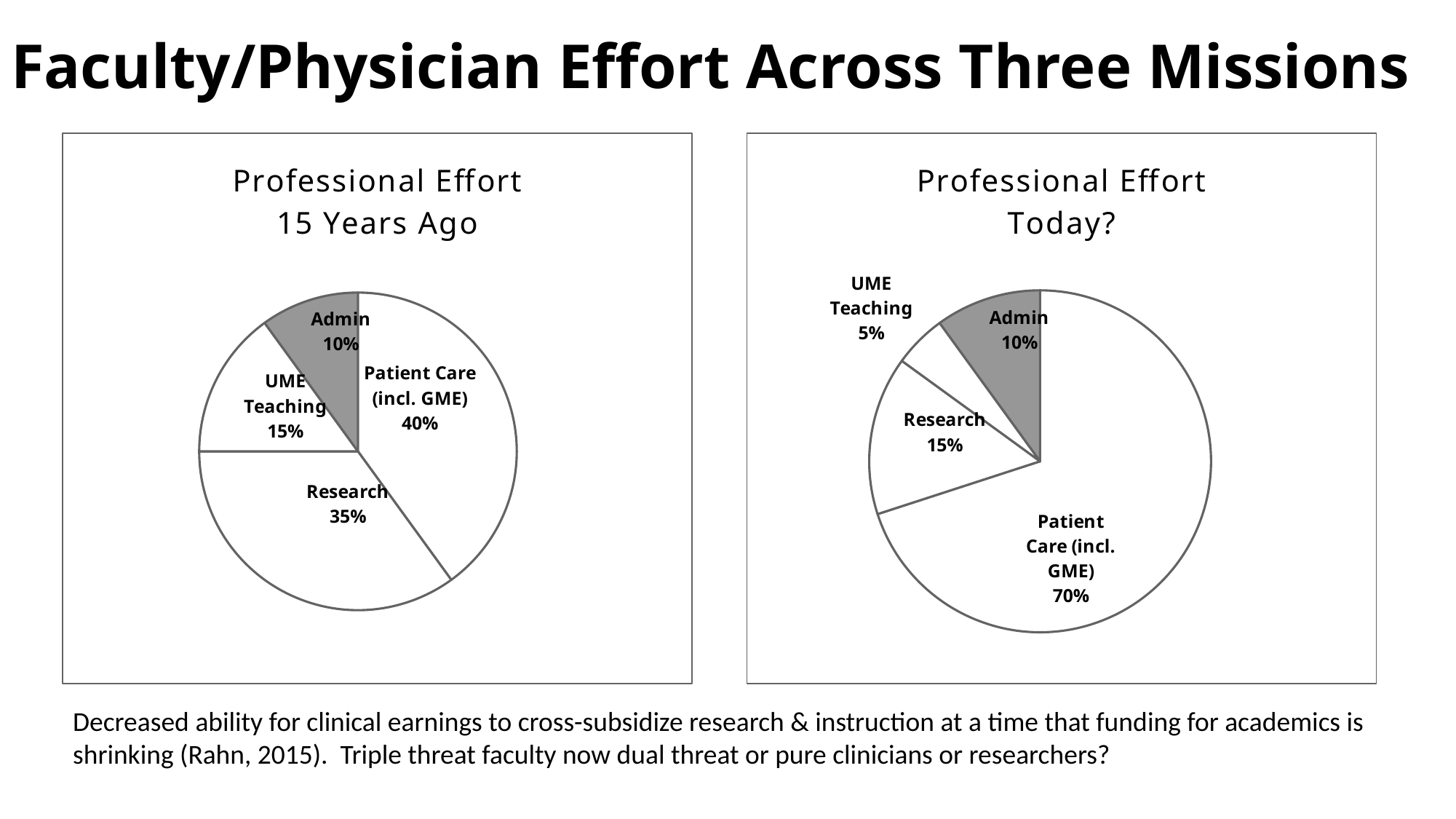
In the 'Professional Effort Today?' chart, which slice is shaded grey? Admin How many slices does the 'Professional Effort Today?' chart have? 4 In the 'Professional Effort 15 Years Ago' chart, which category has the smallest share? Admin In the 'Professional Effort 15 Years Ago' chart, what is the combined share of Research and UME Teaching? 50% What is the difference between the Research share in the 'Professional Effort 15 Years Ago' chart and the Research share in the 'Professional Effort Today?' chart? 20% What kind of chart is the 'Professional Effort 15 Years Ago' chart? Pie chart In the 'Professional Effort 15 Years Ago' chart, what share is Research? 35% In the 'Professional Effort 15 Years Ago' chart, which category has the largest share? Patient Care (incl. GME) In the 'Professional Effort Today?' chart, what share is UME Teaching? 5% In the 'Professional Effort 15 Years Ago' chart, which is larger: Research or UME Teaching? Research In the 'Professional Effort Today?' chart, what share is Patient Care (incl. GME)? 70% In the 'Professional Effort Today?' chart, which category has the smallest share? UME Teaching